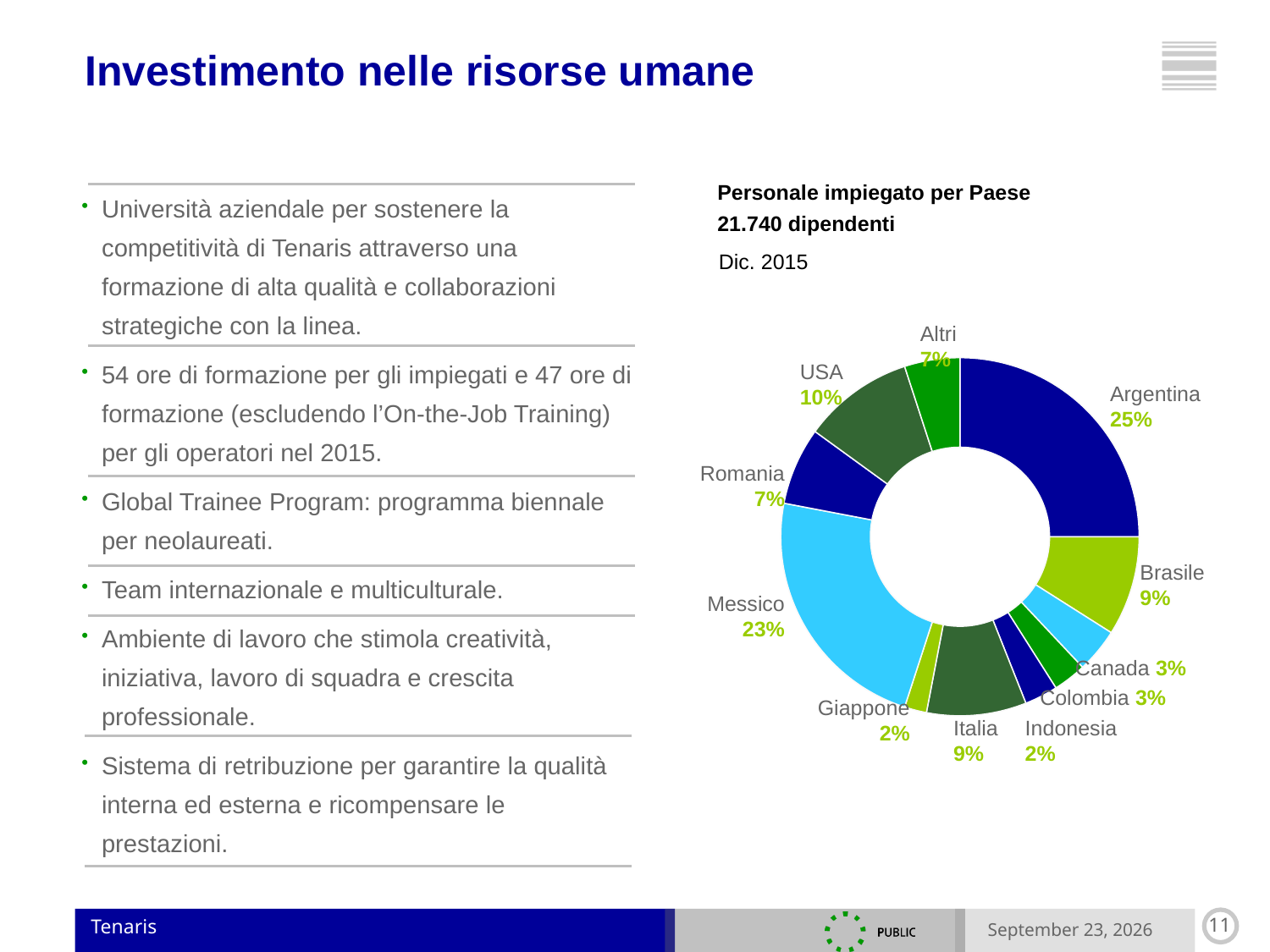
What share of employees is in Messico? 23% What total number of employees is stated above the chart? 21.740 dipendenti Which has a larger share, Brasile or USA? USA What is the title of the chart? Personale impiegato per Paese What kind of chart is shown on the slide? Doughnut (pie) chart What is the difference in percentage points between Argentina and Messico? 2 percentage points What share of employees is in Romania? 7% What is the combined share of Italia and Brasile? 18% How many categories (countries, including Altri) are shown in the chart? 11 Which country has the largest share of employees? Argentina What share of employees is in Argentina? 25% What share of employees is in USA? 10%